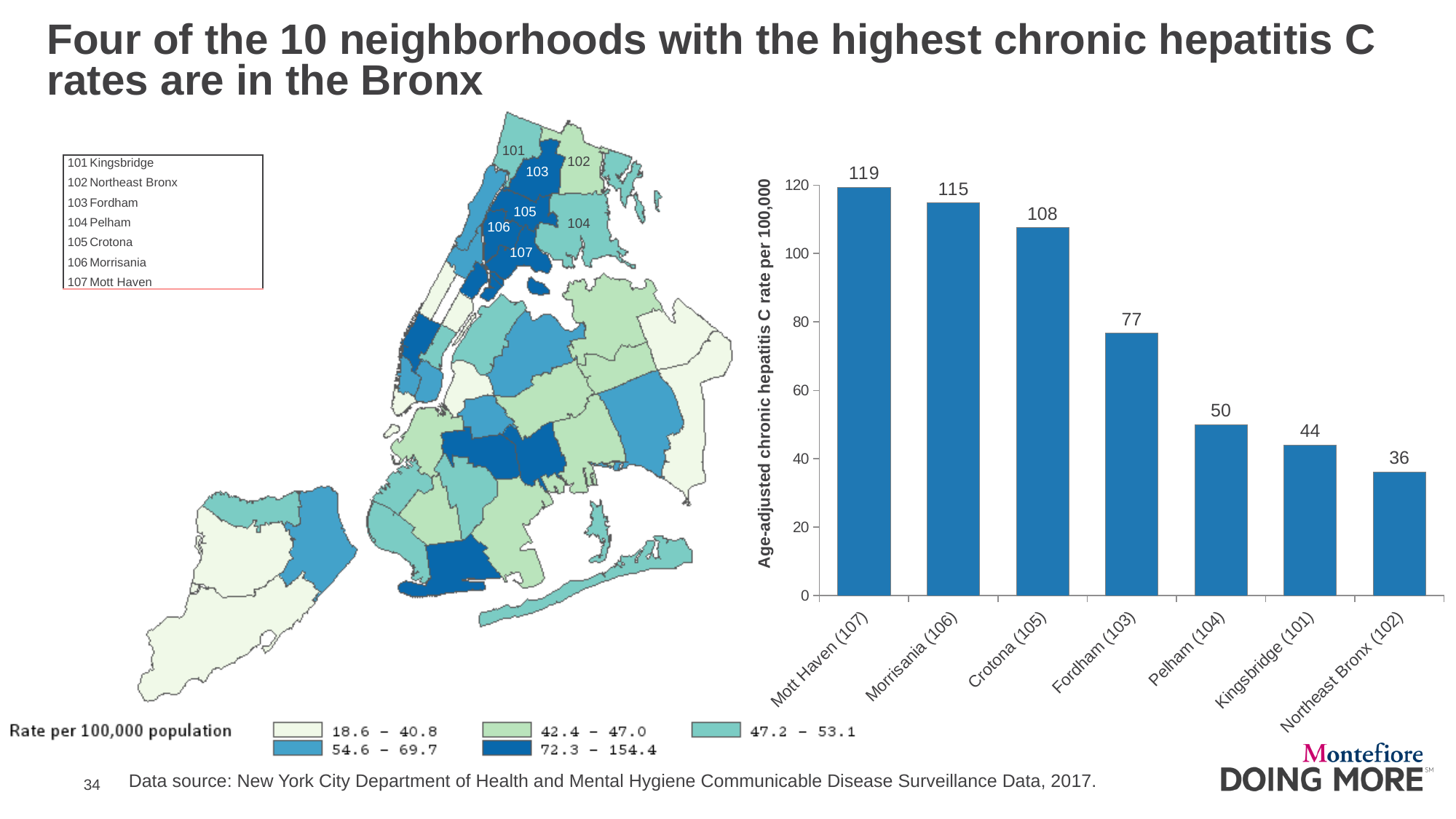
In the bar chart, do the values rise or fall from left to right along the x axis? fall In the bar chart, what is the rate for Fordham (103)? 77 What kind of chart is shown on the right side of the slide? bar chart In the bar chart, what is the rate for Northeast Bronx (102)? 36 In the bar chart, what is the difference between the rates for Morrisania (106) and Crotona (105)? 7 In the bar chart, is the value for Crotona (105) greater or less than 100? greater How many neighborhoods are shown in the bar chart? 7 In the bar chart, which neighborhood has the lowest chronic hepatitis C rate? Northeast Bronx (102) In the bar chart, which neighborhood has the highest chronic hepatitis C rate? Mott Haven (107) In the bar chart, what is the age-adjusted chronic hepatitis C rate per 100,000 for Mott Haven (107)? 119 What is the label on the vertical axis of the bar chart? Age-adjusted chronic hepatitis C rate per 100,000 In the bar chart, which has a higher rate, Pelham (104) or Kingsbridge (101)? Pelham (104)